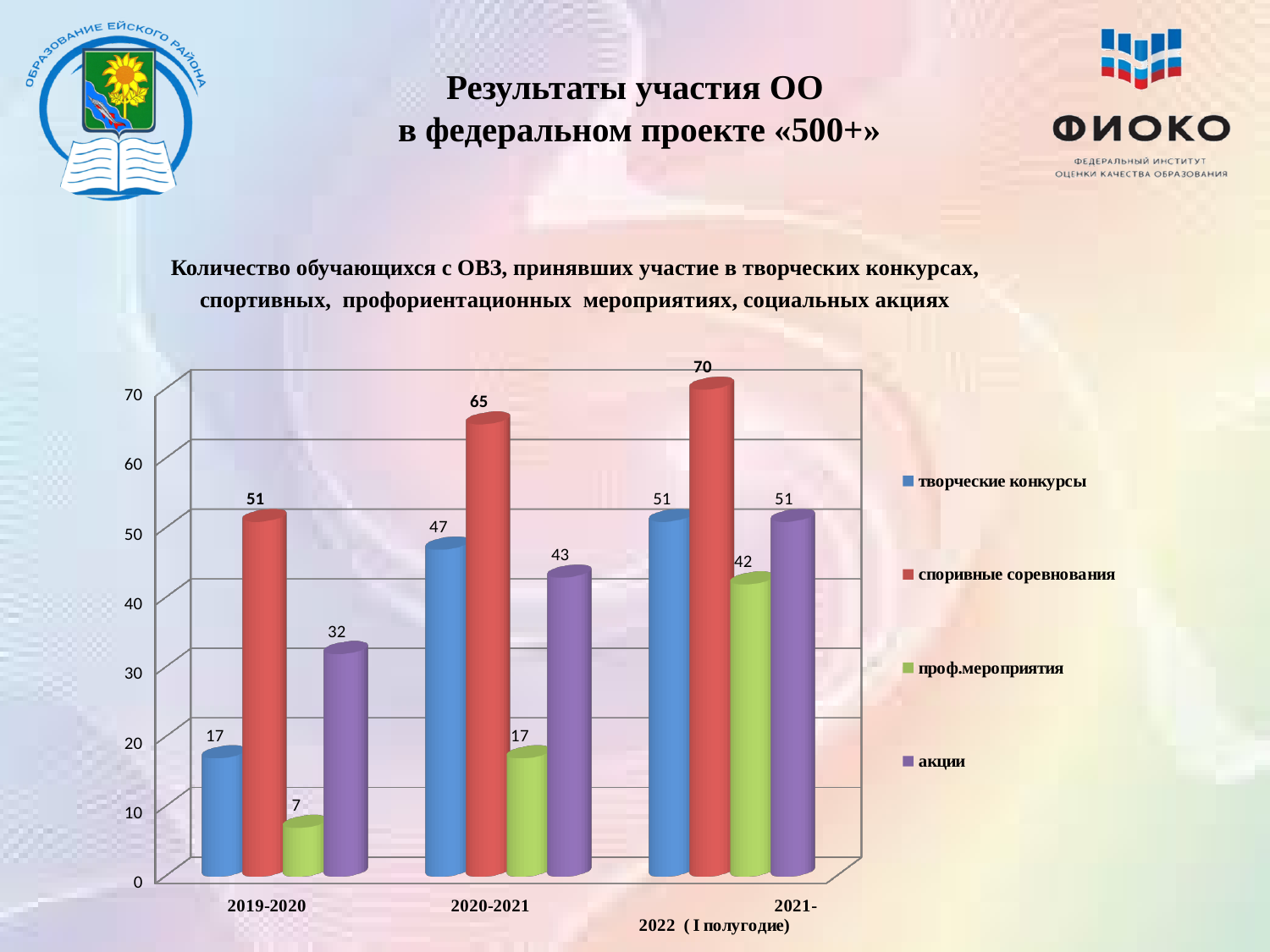
What is the difference between спортивные соревнования in 2021-2022 (I полугодие) and in 2019-2020? 19 In which period is the value for проф.мероприятия lowest? 2019-2020 What is the value for акции in 2021-2022 (I полугодие)? 51 How many series does the legend list? 4 What kind of chart is shown on the slide? bar chart Do the values for творческие конкурсы rise or fall from 2019-2020 to 2021-2022 (I полугодие)? rise How many periods are shown on the x axis? 3 What is the value for проф.мероприятия in 2020-2021? 17 Which is larger in 2020-2021: творческие конкурсы or акции? творческие конкурсы What is the value for спортивные соревнования in 2019-2020? 51 What is the value for творческие конкурсы in 2020-2021? 47 In which period is the value for спортивные соревнования highest? 2021-2022 (I полугодие)